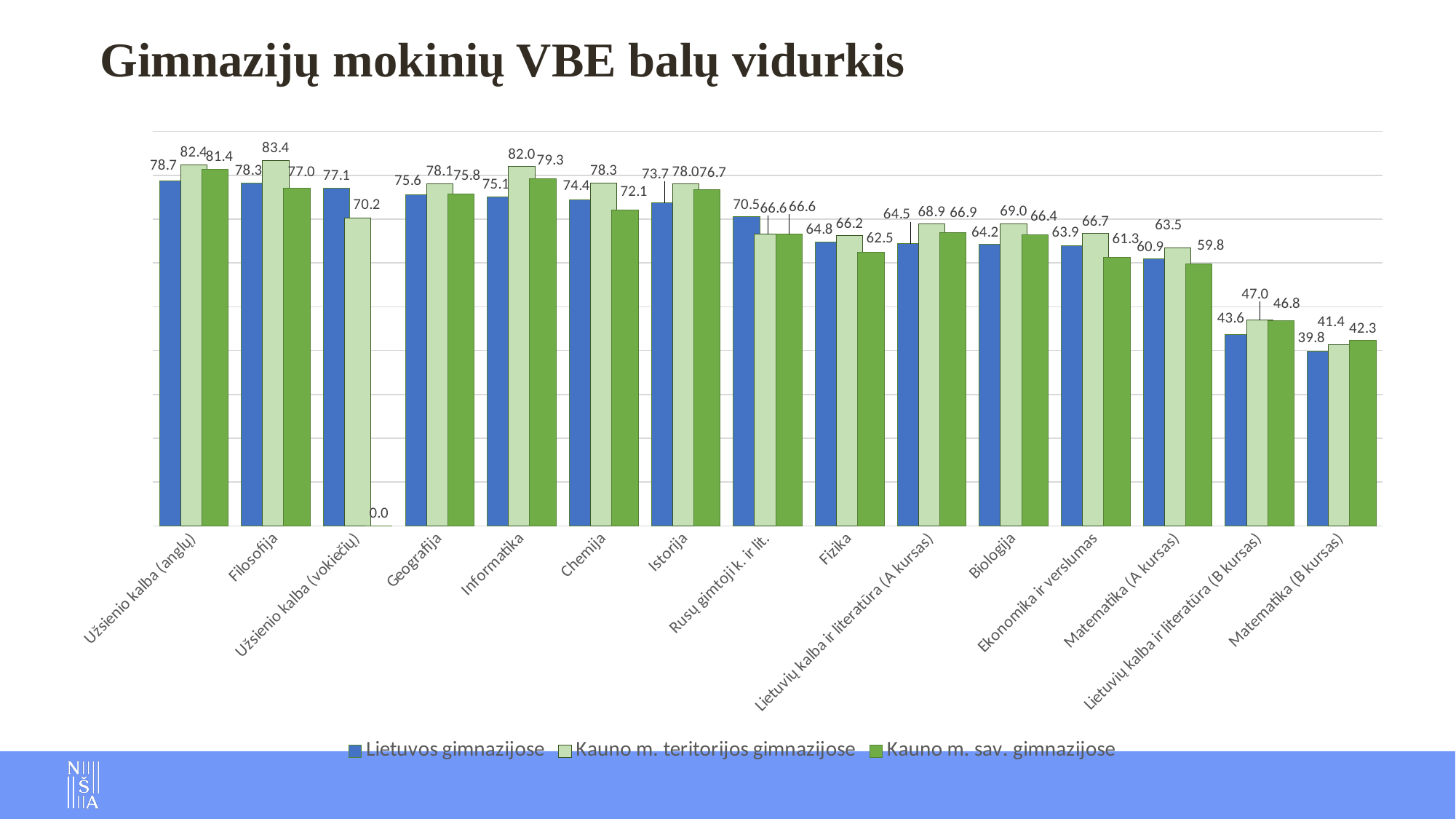
What is the title of the chart? Gimnazijų mokinių VBE balų vidurkis What is the value for Informatika in the Kauno m. teritorijos gimnazijose series? 82.0 What type of chart is shown on the slide? bar chart What is the value for Matematika (B kursas) in the Kauno m. sav. gimnazijose series? 42.3 Which category has the lowest value in the Lietuvos gimnazijose series? Matematika (B kursas) Which category has the highest value in the Kauno m. teritorijos gimnazijose series? Filosofija What is the difference between the Kauno m. teritorijos gimnazijose and Lietuvos gimnazijose values for Informatika? 6.9 How many series does the legend list? 3 How many subject categories are shown on the x axis? 15 What is the value for Fizika in the Lietuvos gimnazijose series? 64.8 Do the Lietuvos gimnazijose values generally rise or fall from left to right along the x axis? fall For Rusų gimtoji k. ir lit., which is larger: the Lietuvos gimnazijose value or the Kauno m. sav. gimnazijose value? Lietuvos gimnazijose